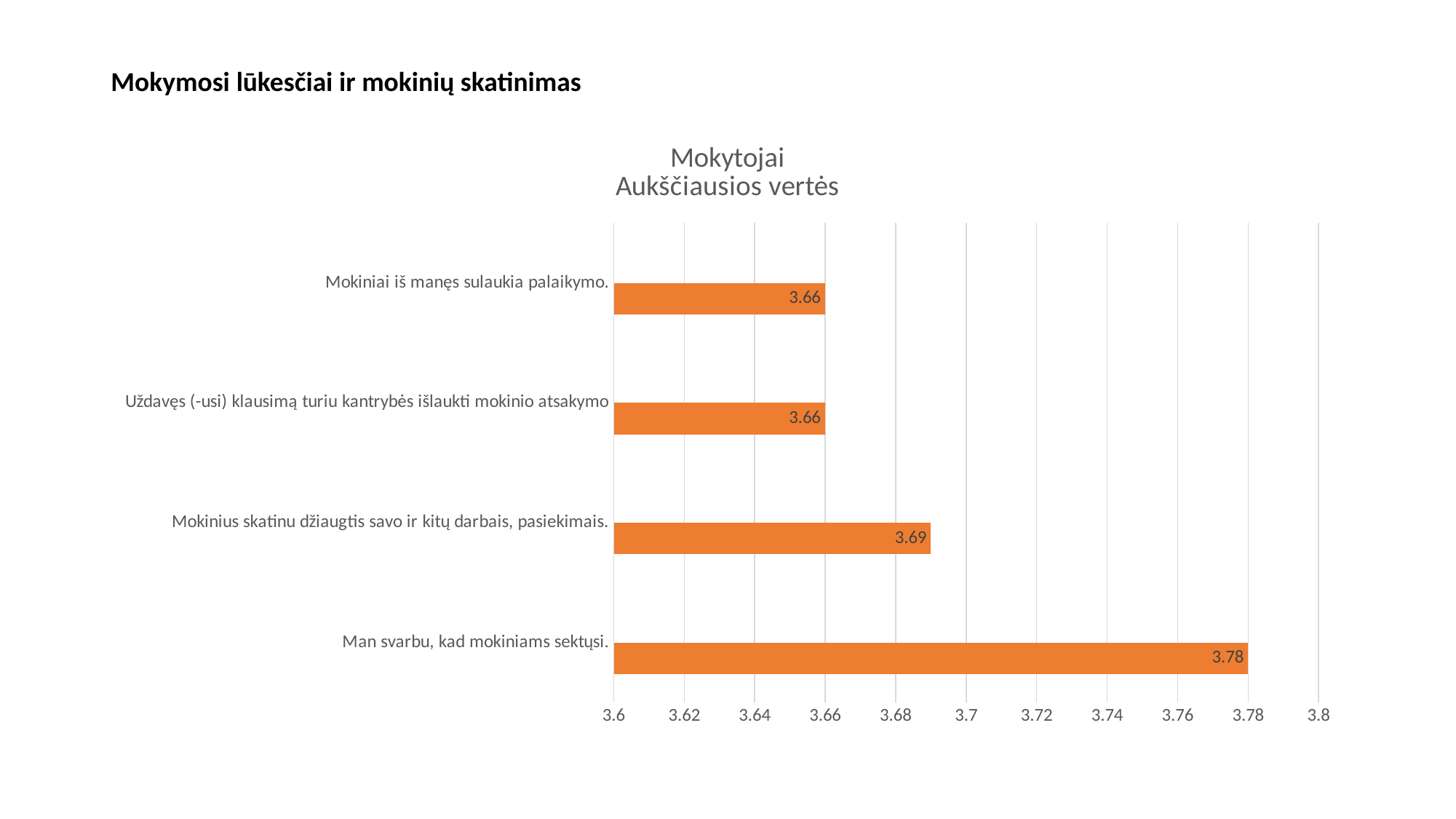
What is the value for "Mokiniai iš manęs sulaukia palaikymo."? 3.66 Is the value for "Mokinius skatinu džiaugtis savo ir kitų darbais, pasiekimais." greater or less than 3.7? less What is the value for "Man svarbu, kad mokiniams sektųsi."? 3.78 Which category has the highest value? Man svarbu, kad mokiniams sektųsi. What is the difference between the values for "Man svarbu, kad mokiniams sektųsi." and "Mokinius skatinu džiaugtis savo ir kitų darbais, pasiekimais."? 0.09 What kind of chart is shown on the slide? Bar chart How many categories are shown in the chart? 4 What is the title of the chart? Mokytojai Aukščiausios vertės What is the value for "Uždavęs (-usi) klausimą turiu kantrybės išlaukti mokinio atsakymo"? 3.66 Which is larger: the value for "Man svarbu, kad mokiniams sektųsi." or the value for "Mokiniai iš manęs sulaukia palaikymo."? Man svarbu, kad mokiniams sektųsi. What is the value for "Mokinius skatinu džiaugtis savo ir kitų darbais, pasiekimais."? 3.69 What is the difference between the values for "Mokinius skatinu džiaugtis savo ir kitų darbais, pasiekimais." and "Mokiniai iš manęs sulaukia palaikymo."? 0.03